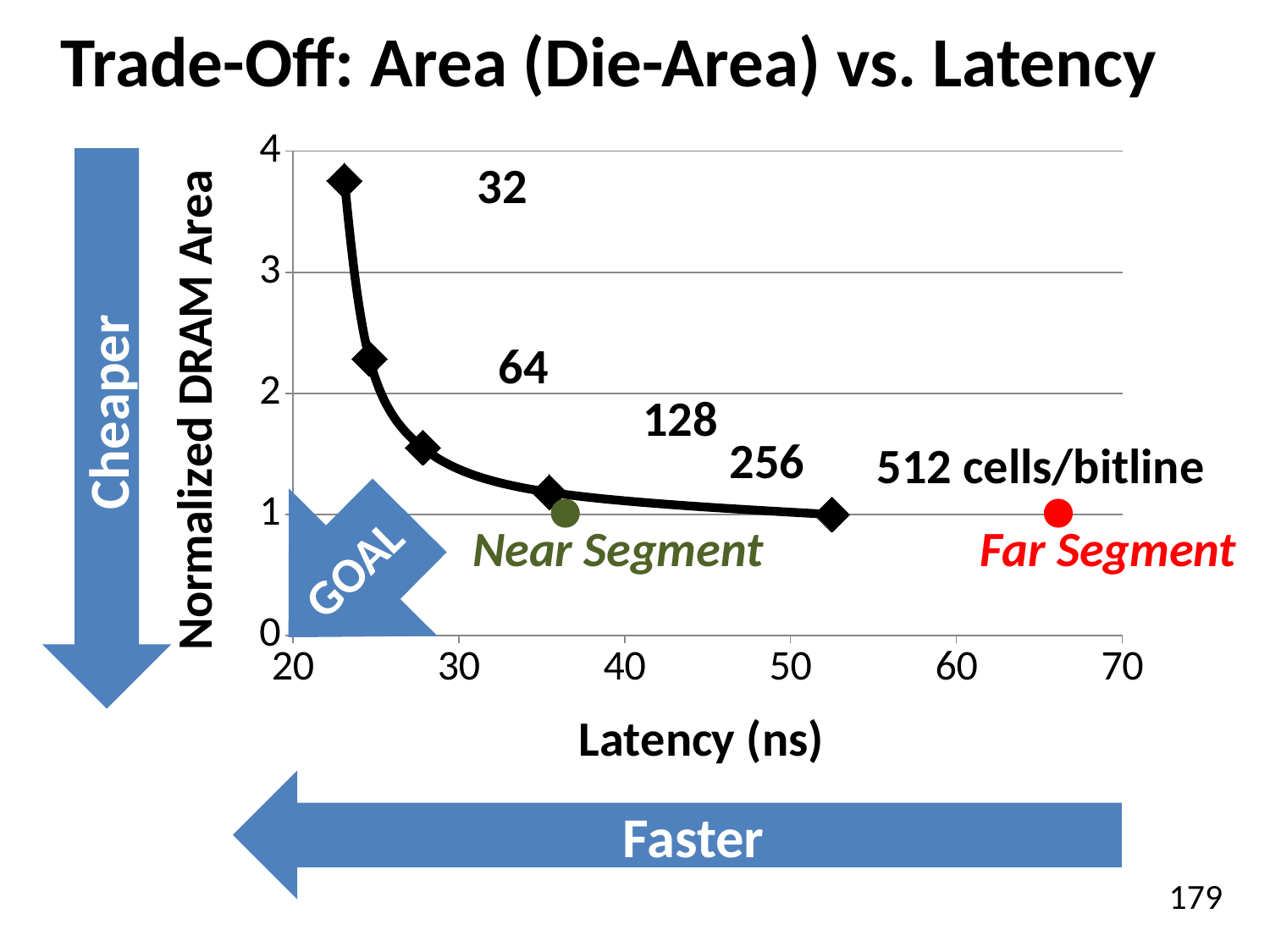
Which cells/bitline configuration has the highest latency? 512 Is the latency of the Far Segment point greater or less than 60 ns? greater Is the latency for 512 cells/bitline greater or less than 50 ns? greater What is the label of the x axis? Latency (ns) Is the normalized DRAM area for 32 cells/bitline greater or less than 3? greater What kind of chart is shown on the slide? line chart How many cells/bitline configurations are plotted as diamond points on the black curve? 5 Which cells/bitline configuration has the lowest latency? 32 Which cells/bitline configuration has the highest normalized DRAM area? 32 As the number of cells/bitline increases along the curve, does the normalized DRAM area rise or fall? fall What is the title of the chart on this slide? Trade-Off: Area (Die-Area) vs. Latency